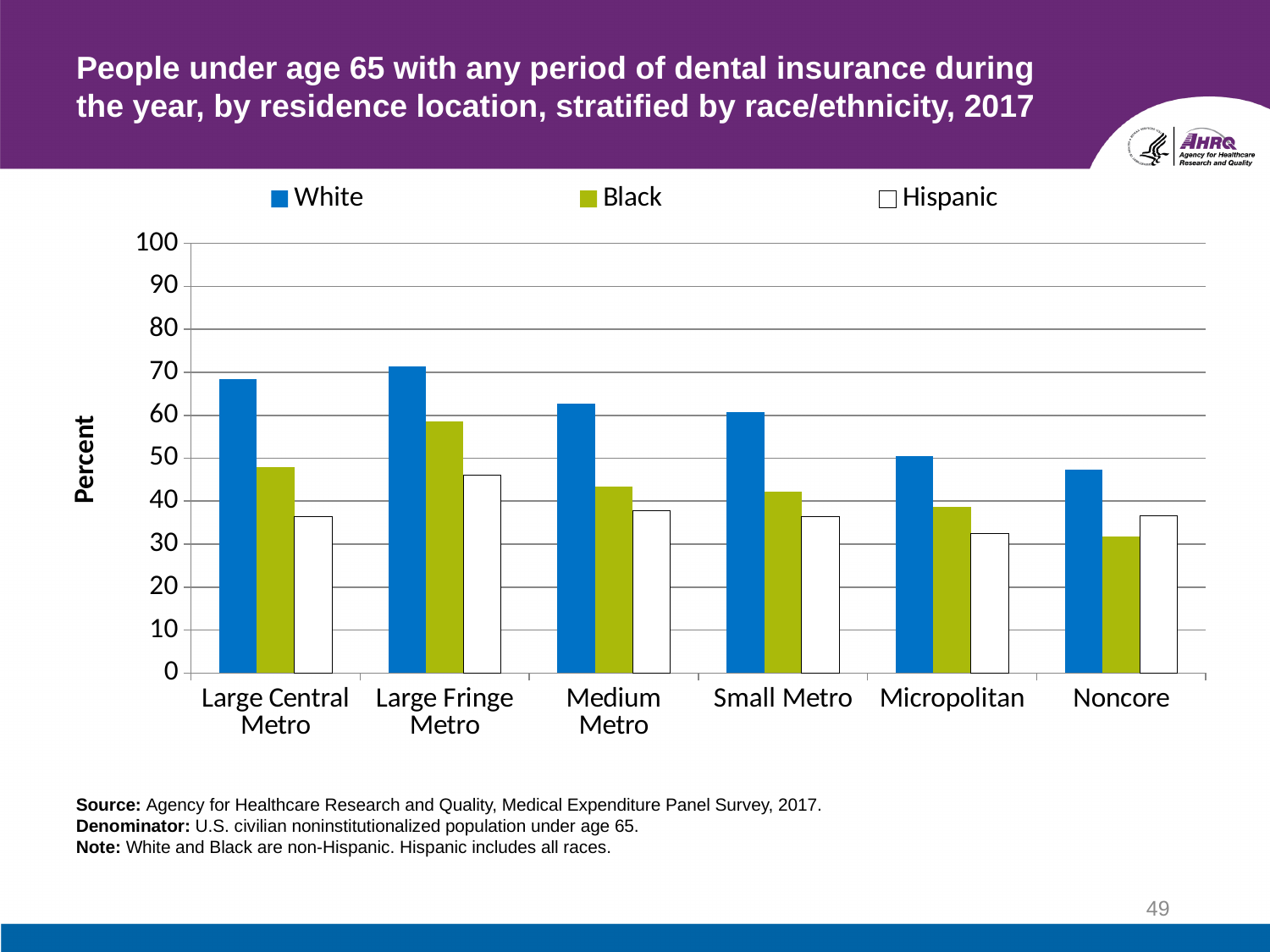
Is the value for Hispanic in Large Fringe Metro greater or less than 40? greater In Noncore, which is larger, the value for Black or the value for Hispanic? Hispanic Which residence location has the lowest value for Black? Noncore What is the label of the y axis? Percent Is the value for Hispanic in Micropolitan greater or less than 40? less Which residence location has the highest value for Hispanic? Large Fringe Metro How many series does the legend list? 3 How many residence location categories are shown on the x axis? 6 Is the value for White in Large Central Metro greater or less than 60? greater What kind of chart is shown on the slide? bar chart Which residence location has the highest value for White? Large Fringe Metro